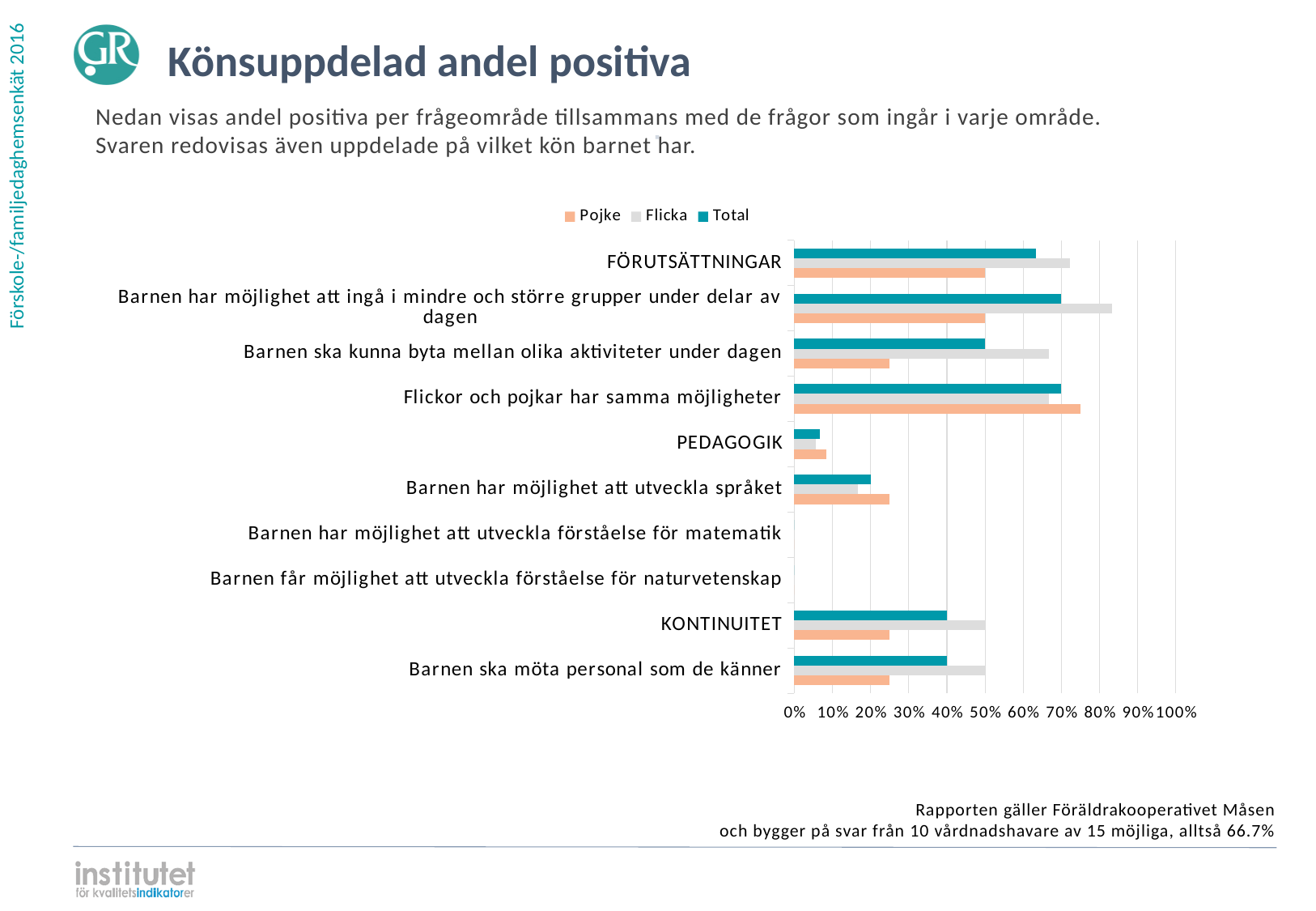
Is the Flicka value for 'Barnen har möjlighet att ingå i mindre och större grupper under delar av dagen' greater or less than 80%? greater How many categories are shown on the vertical axis of the chart? 10 For FÖRUTSÄTTNINGAR, which is larger: the Flicka value or the Pojke value? Flicka What is the title of the slide containing the chart? Könsuppdelad andel positiva Is the Pojke value for 'Barnen ska kunna byta mellan olika aktiviteter under dagen' greater or less than 30%? less Which series are listed in the chart legend? Pojke, Flicka, Total For 'Flickor och pojkar har samma möjligheter', which is larger: the Pojke value or the Flicka value? Pojke Is the Total value for KONTINUITET greater or less than 50%? less What kind of chart is shown on the slide? Bar chart How many series does the legend list? 3 Which category has the highest Pojke value? Flickor och pojkar har samma möjligheter